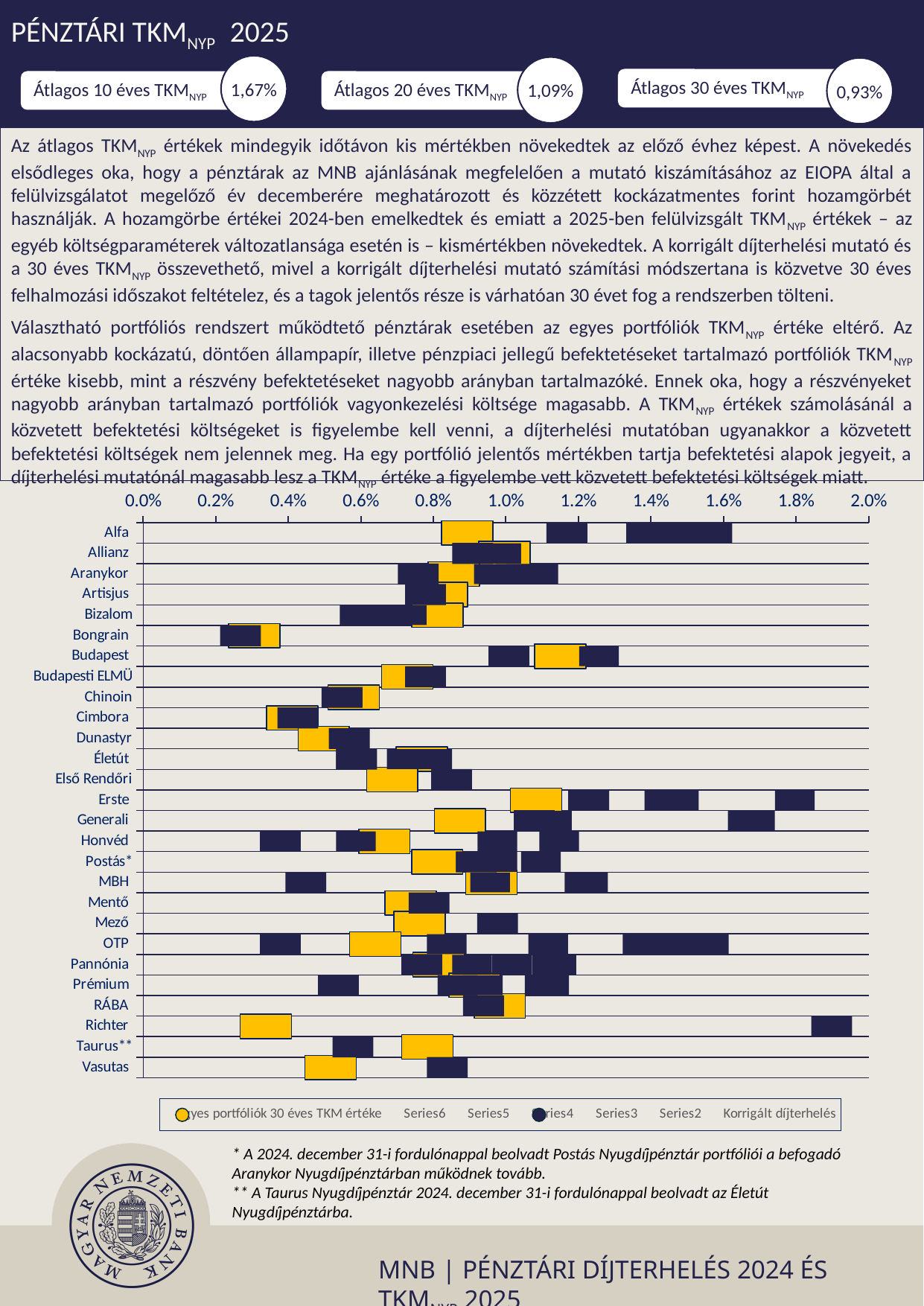
How many series does the chart legend list? 7 How many pension funds (categories) are listed on the vertical axis of the chart? 27 Is the yellow marker for Bongrain greater or less than 0.6%? less What is the highest value shown on the chart's horizontal axis? 2.0% Is the rightmost dark marker for Richter greater or less than 1.8%? greater What is the last entry in the chart legend? Korrigált díjterhelés Which category appears first (at the top) on the chart's vertical axis? Alfa Is the yellow marker for Vasutas greater or less than 0.8%? less